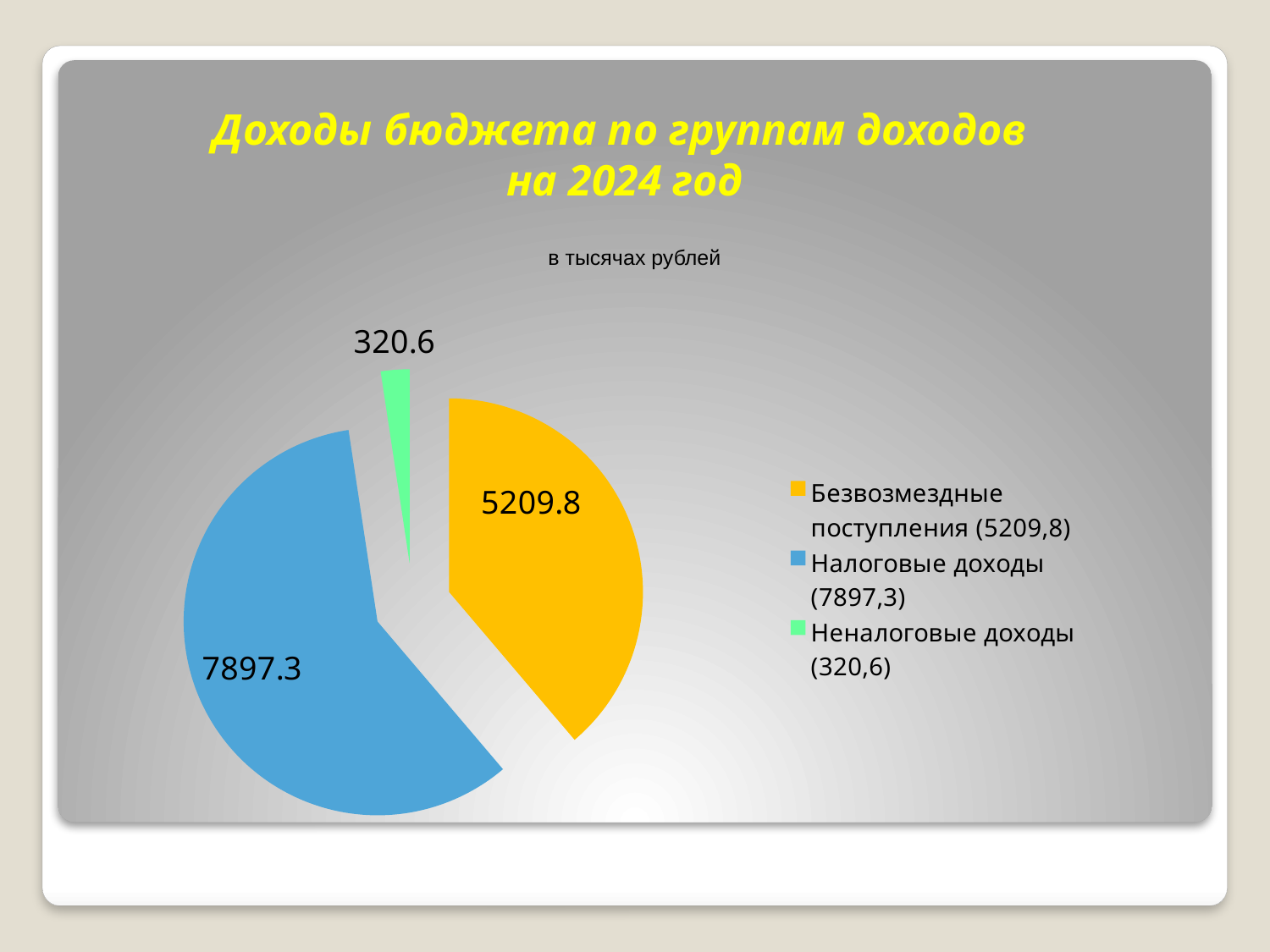
Which category has the largest slice of the pie? Налоговые доходы Which is larger, Безвозмездные поступления or Неналоговые доходы? Безвозмездные поступления What is the title of the chart? Доходы бюджета по группам доходов на 2024 год Which category has the smallest slice of the pie? Неналоговые доходы How many categories are shown in the pie chart? 3 What is the value for Безвозмездные поступления? 5209.8 What is the value for Налоговые доходы? 7897.3 In what units are the values on the chart given? в тысячах рублей What is the value for Неналоговые доходы? 320.6 What is the difference between Безвозмездные поступления and Неналоговые доходы? 4889.2 What is the difference between Налоговые доходы and Безвозмездные поступления? 2687.5 What kind of chart is shown on the slide? Pie chart